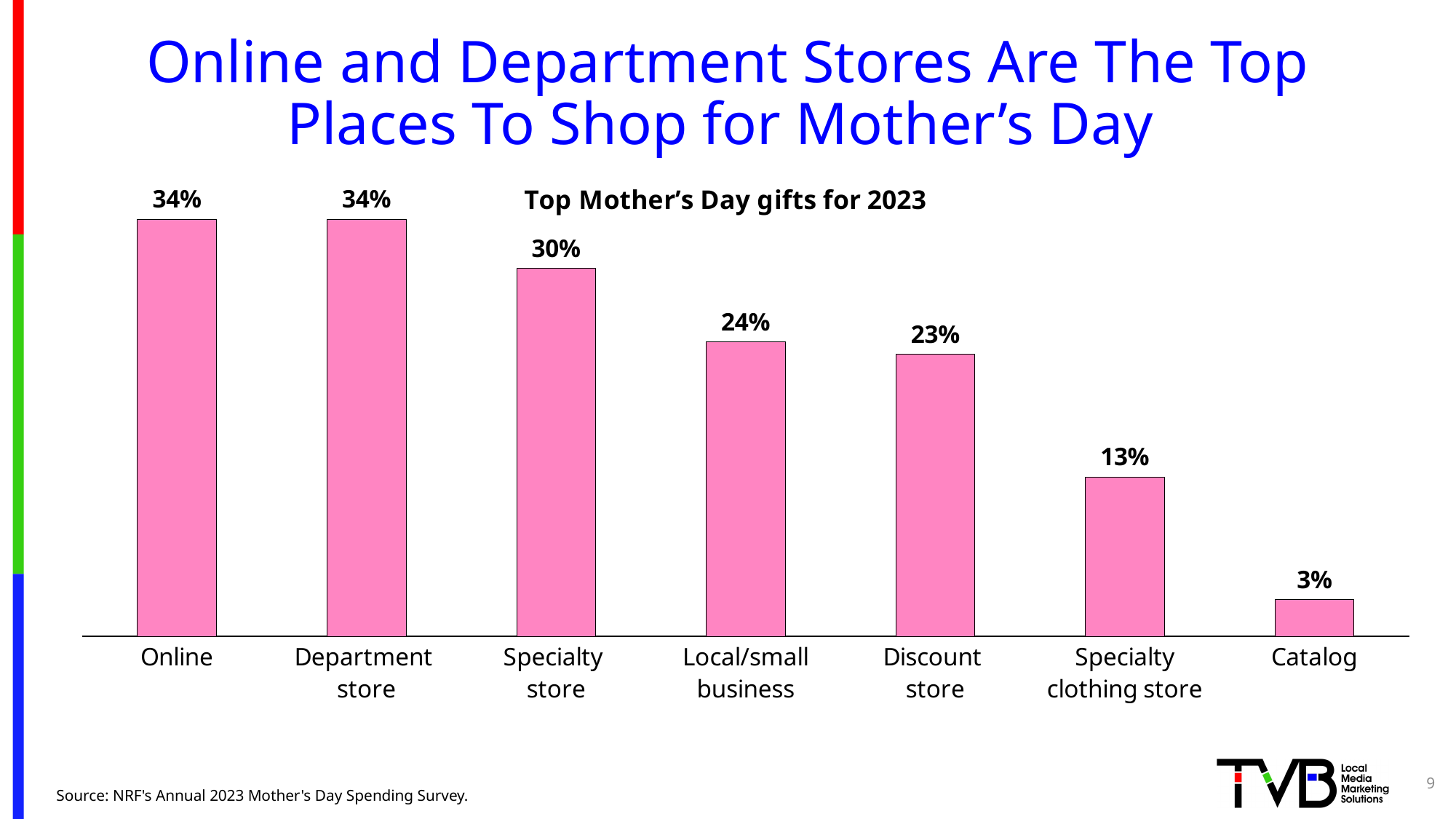
What is the title of the chart? Top Mother’s Day gifts for 2023 What kind of chart is shown on the slide? Bar chart What is the value for Local/small business? 24% Which category has the lowest value? Catalog Which is larger, the value for Local/small business or the value for Specialty clothing store? Local/small business What is the value for Online? 34% What is the value for Specialty clothing store? 13% Do the values rise or fall from left to right along the x axis? Fall What is the value for Specialty store? 30% How many categories are shown in the chart? 7 What is the difference between the values for Department store and Discount store? 11% What is the difference between the values for Specialty store and Catalog? 27%